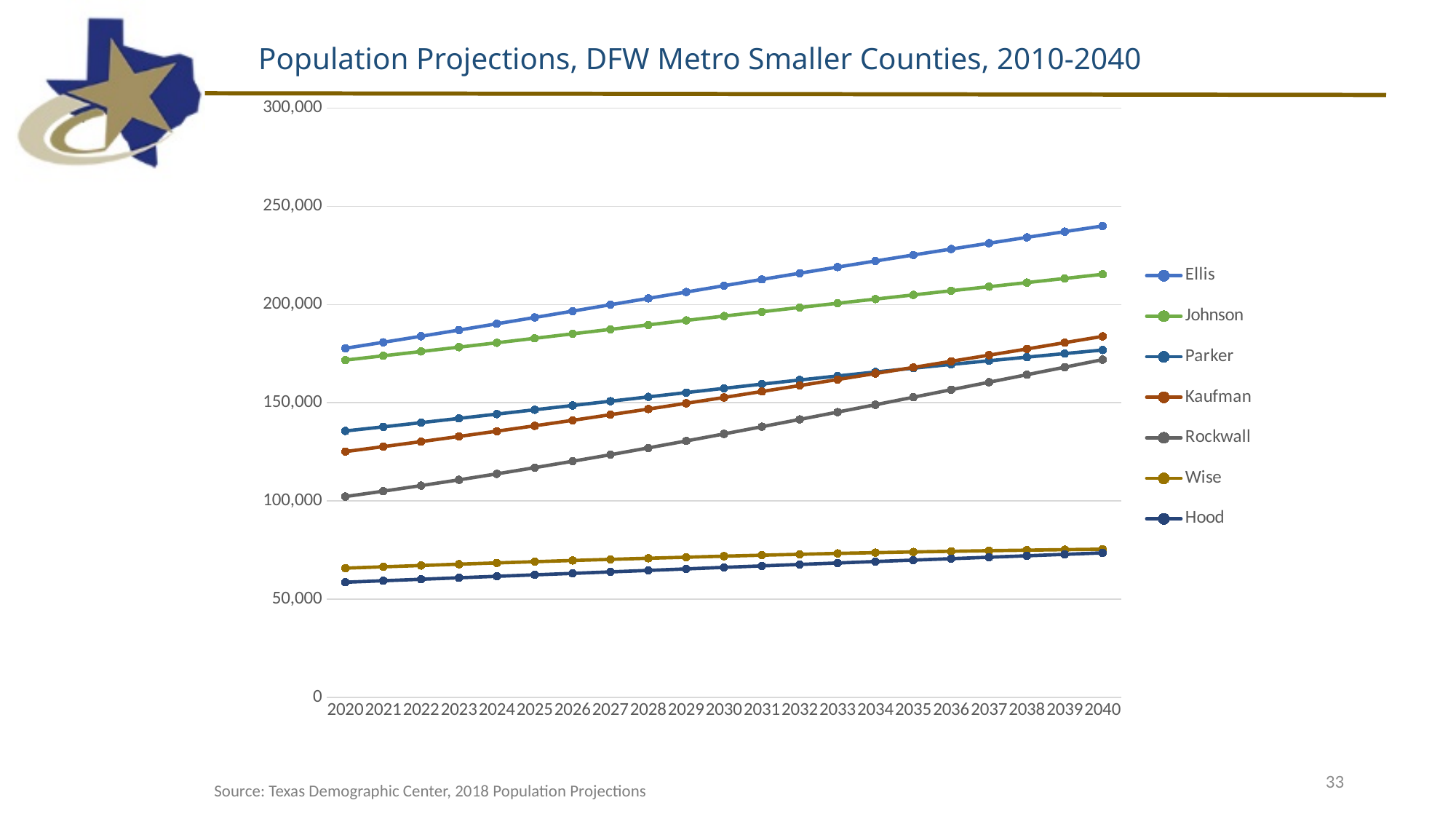
How many years are shown along the x axis? 21 Is the value for Ellis in 2040 greater or less than 200,000? greater What is the title of the chart? Population Projections, DFW Metro Smaller Counties, 2010-2040 Which county has the lowest projected population in 2020? Hood Is the value for Parker in 2020 greater or less than 150,000? less How many series does the legend list? 7 Do the projected populations rise or fall from 2020 to 2040? rise Which county has the highest projected population in 2040? Ellis What kind of chart is shown on the slide? line chart Is the value for Kaufman in 2040 greater or less than 150,000? greater In 2020, which is larger, the value for Kaufman or the value for Rockwall? Kaufman